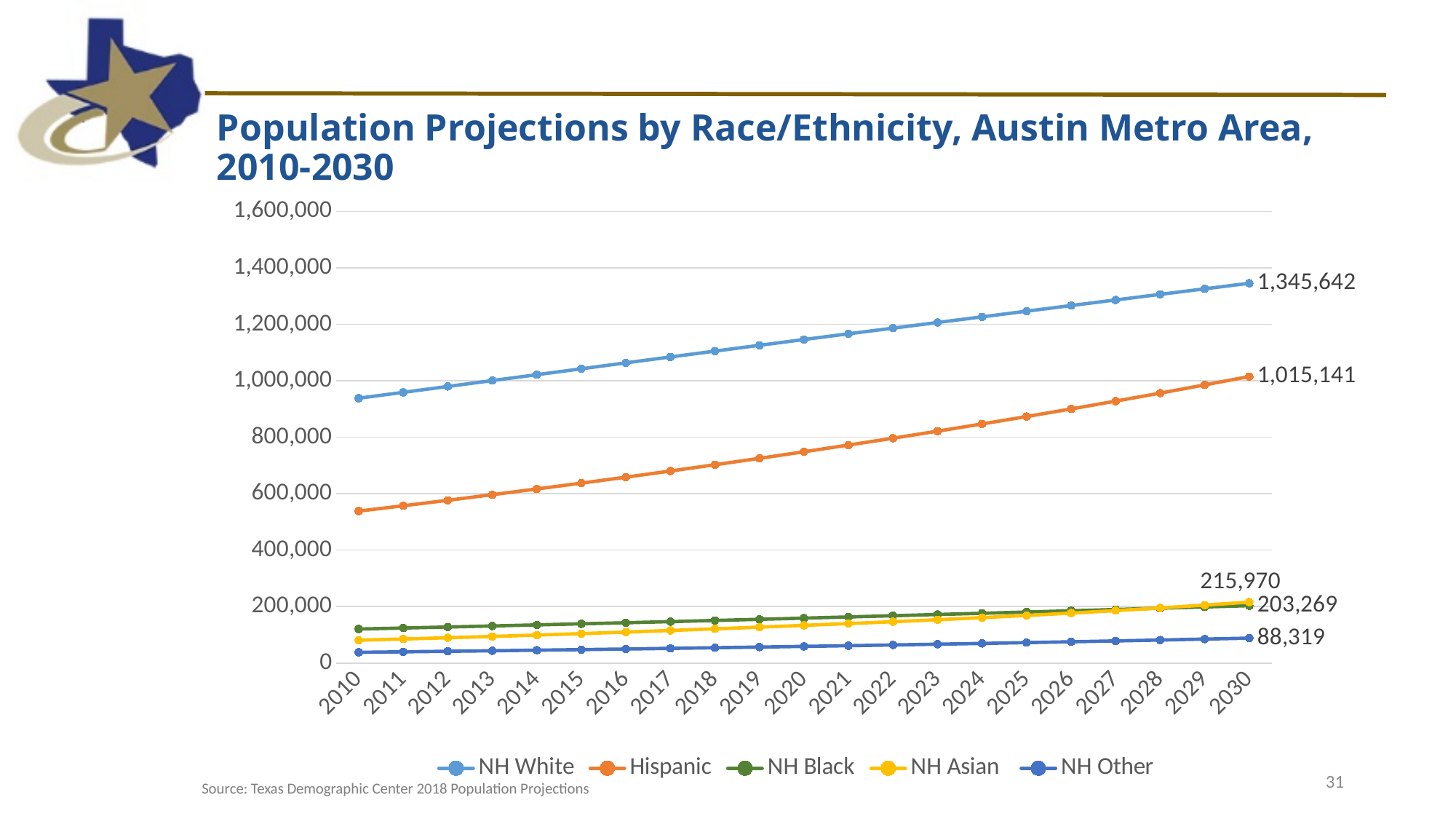
Which series has the highest value in 2030? NH White Does the Hispanic series rise or fall from 2010 to 2030? rise What is the projected NH White population in 2030? 1,345,642 What is the difference between the NH White and Hispanic values in 2030? 330,501 What is the projected NH Other population in 2030? 88,319 What type of chart is shown on the slide? line chart Which series has the lowest value in 2030? NH Other How many series does the legend list? 5 What is the projected Hispanic population in 2030? 1,015,141 What is the projected NH Asian population in 2030? 215,970 How many years are shown along the x axis? 21 Is the Hispanic value in 2010 greater or less than 600,000? less